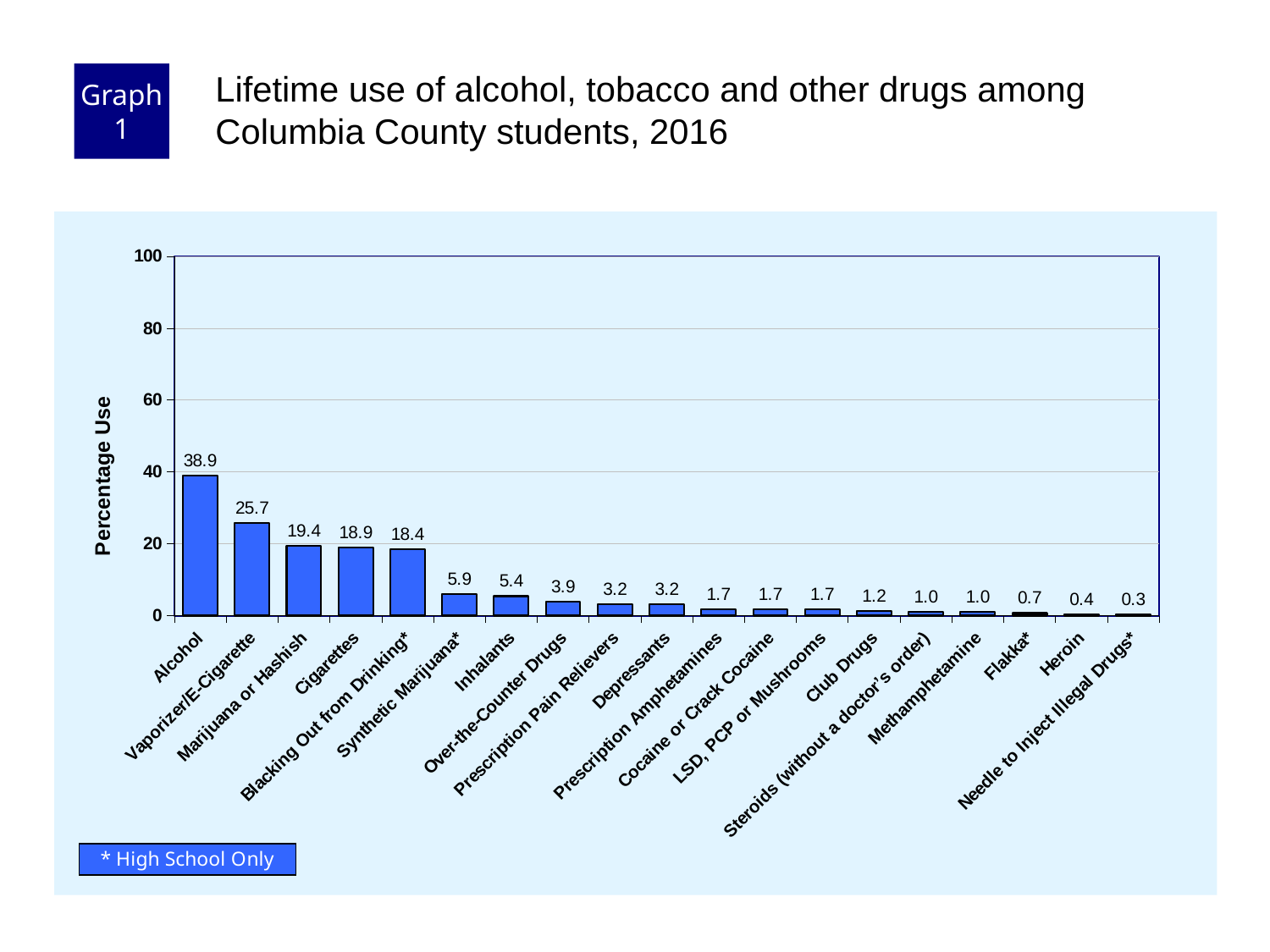
What is the percentage use for Alcohol? 38.9 What is the label of the y axis? Percentage Use What is the difference in percentage use between Alcohol and Vaporizer/E-Cigarette? 13.2 Is the value for Marijuana or Hashish greater or less than 20? less Which category has the lowest percentage use? Needle to Inject Illegal Drugs* How many categories are shown on the chart? 19 What kind of chart is shown on the slide? Bar chart What is the percentage use for Vaporizer/E-Cigarette? 25.7 What is the percentage use for Heroin? 0.4 Which has a higher percentage use, Cigarettes or Blacking Out from Drinking*? Cigarettes Which category has the highest percentage use? Alcohol What is the percentage use for Inhalants? 5.4